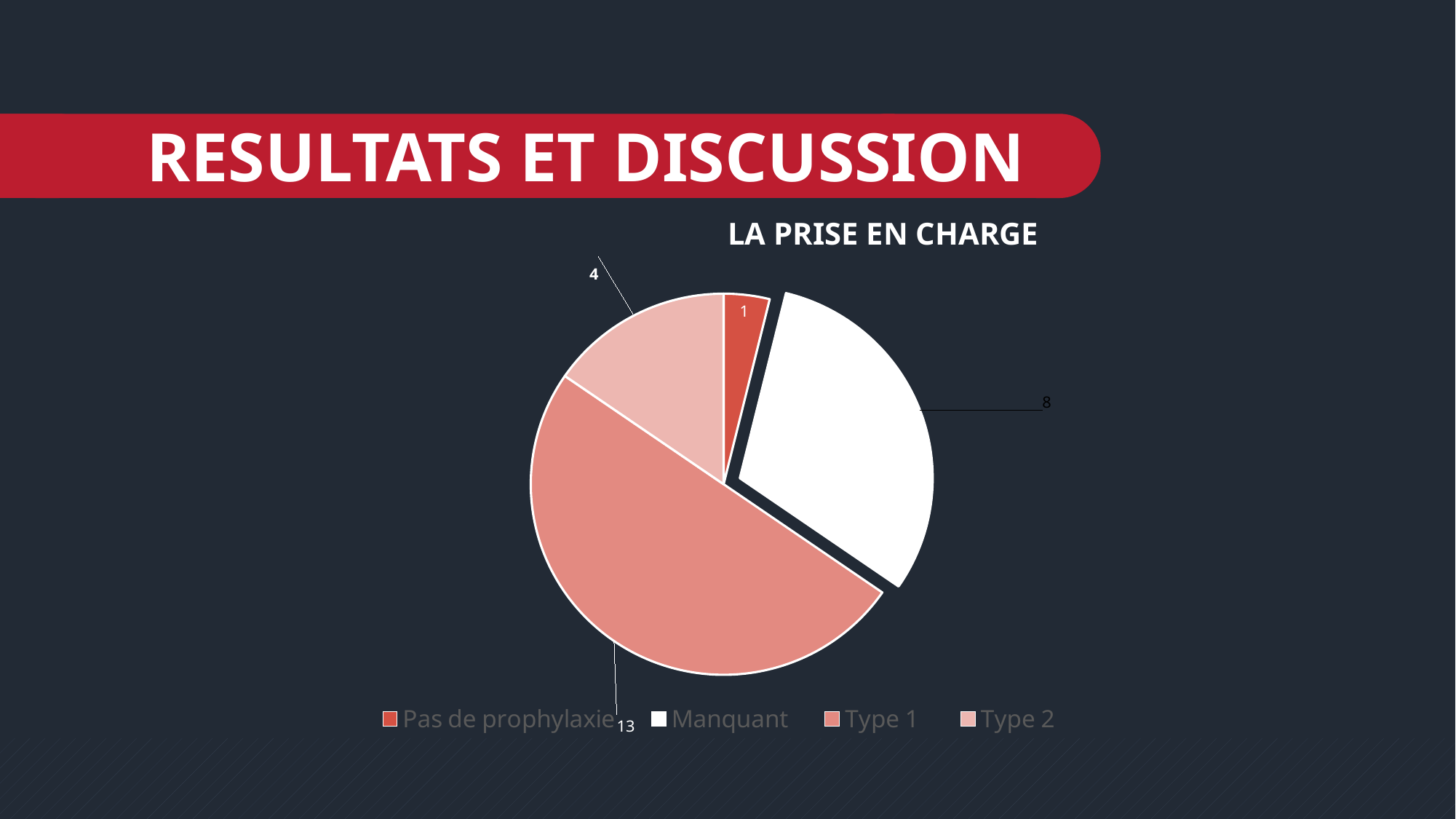
What kind of chart is shown on the slide? Pie chart What is the value for Pas de prophylaxie? 1 Which category has the largest slice? Type 1 What is the value for Manquant? 8 What is the value for Type 1? 13 What share of the pie does Type 1 represent? 50% Which category has the smallest slice? Pas de prophylaxie What is the difference between the values for Type 1 and Manquant? 5 How many categories does the legend list? 4 What is the title of the chart? LA PRISE EN CHARGE What is the value for Type 2? 4 Which is larger, the value for Manquant or the value for Type 2? Manquant